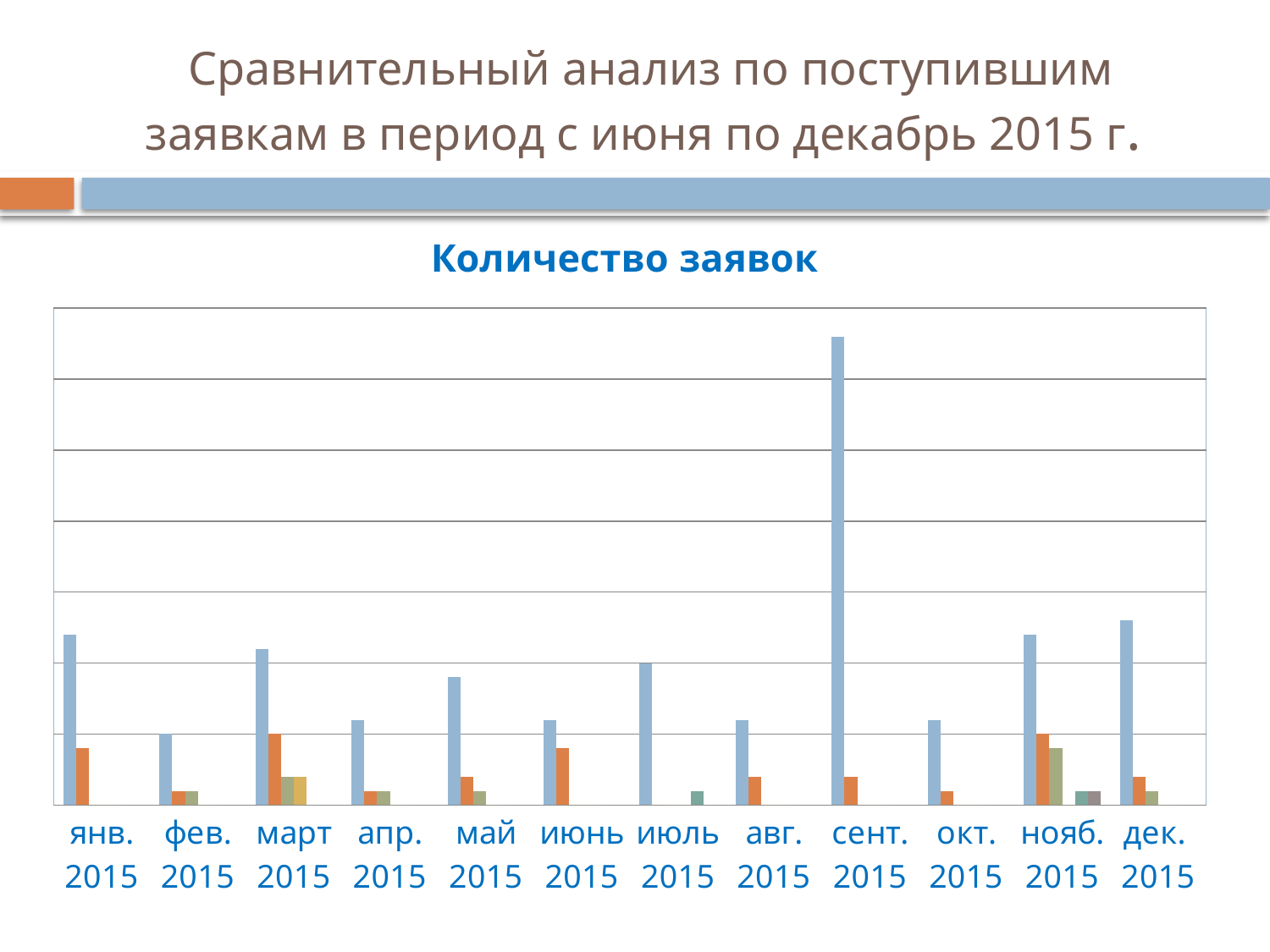
Which month has the taller blue bar, июль 2015 or авг. 2015? июль 2015 In янв. 2015, which bar is taller, the blue one or the orange one? the blue one How many months (categories) are shown along the x axis of the chart? 12 What is the label of the first category on the x axis? янв. 2015 Which month has the taller blue bar, окт. 2015 or нояб. 2015? нояб. 2015 What is the title of the chart? Количество заявок In which month does the tallest blue bar appear? сент. 2015 What kind of chart is shown on the slide? bar chart